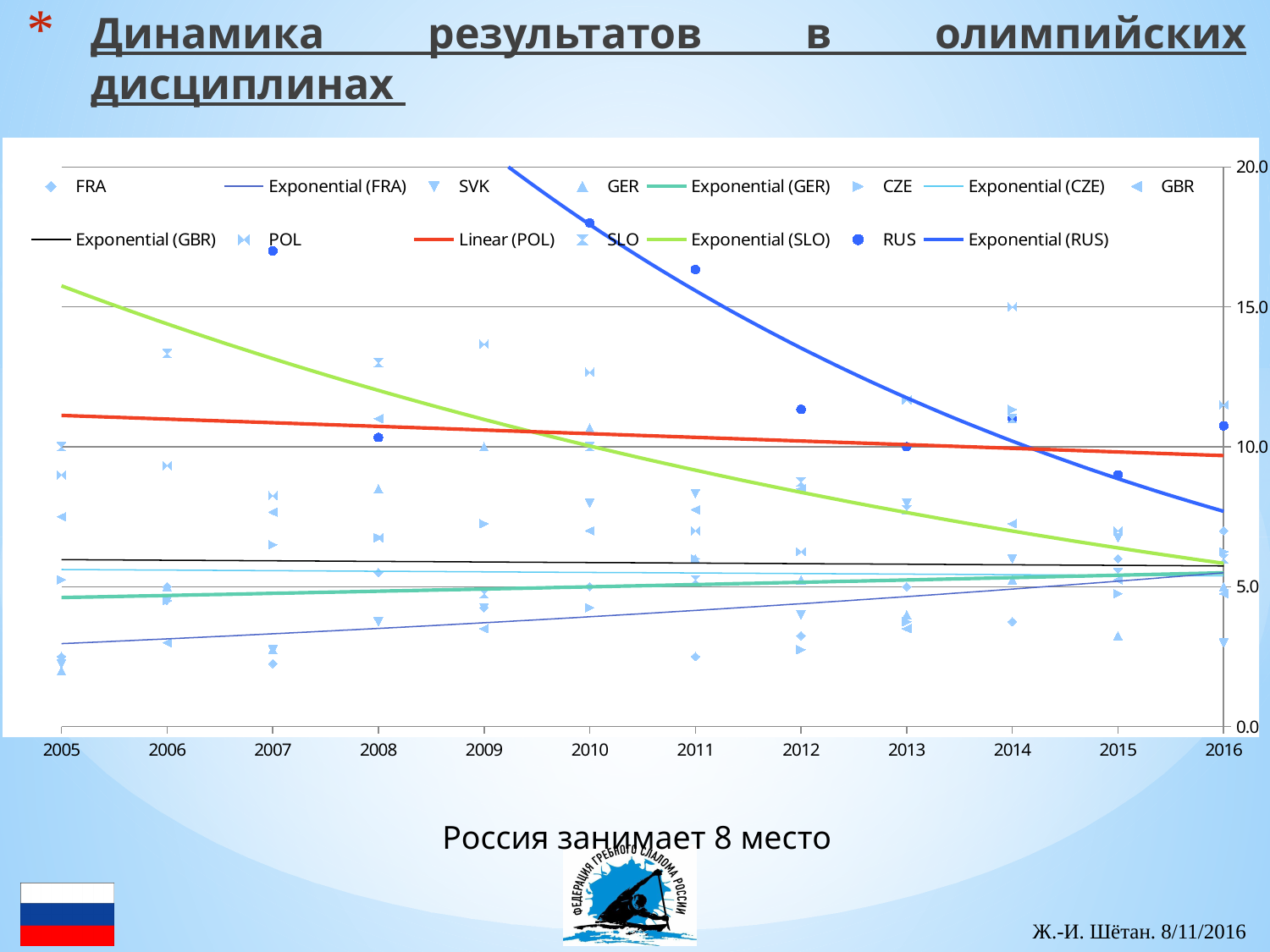
How many countries are plotted as data series in the chart? 8 What kind of chart is shown on the slide? scatter chart Does the Exponential (FRA) trendline rise or fall from 2005 to 2016? rise What colour is the Linear (POL) trendline in the chart? red What is the first year shown on the x axis of the chart? 2005 How many years are shown along the x axis of the chart? 12 Is the value for RUS in 2010 greater or less than 15.0? greater Is the value for RUS in 2011 greater or less than 15.0? greater Does the Exponential (SLO) trendline rise or fall from 2005 to 2016? fall Is the value for RUS in 2015 greater or less than 10.0? less How many entries does the chart legend list? 15 Does the Exponential (RUS) trendline rise or fall from 2005 to 2016? fall